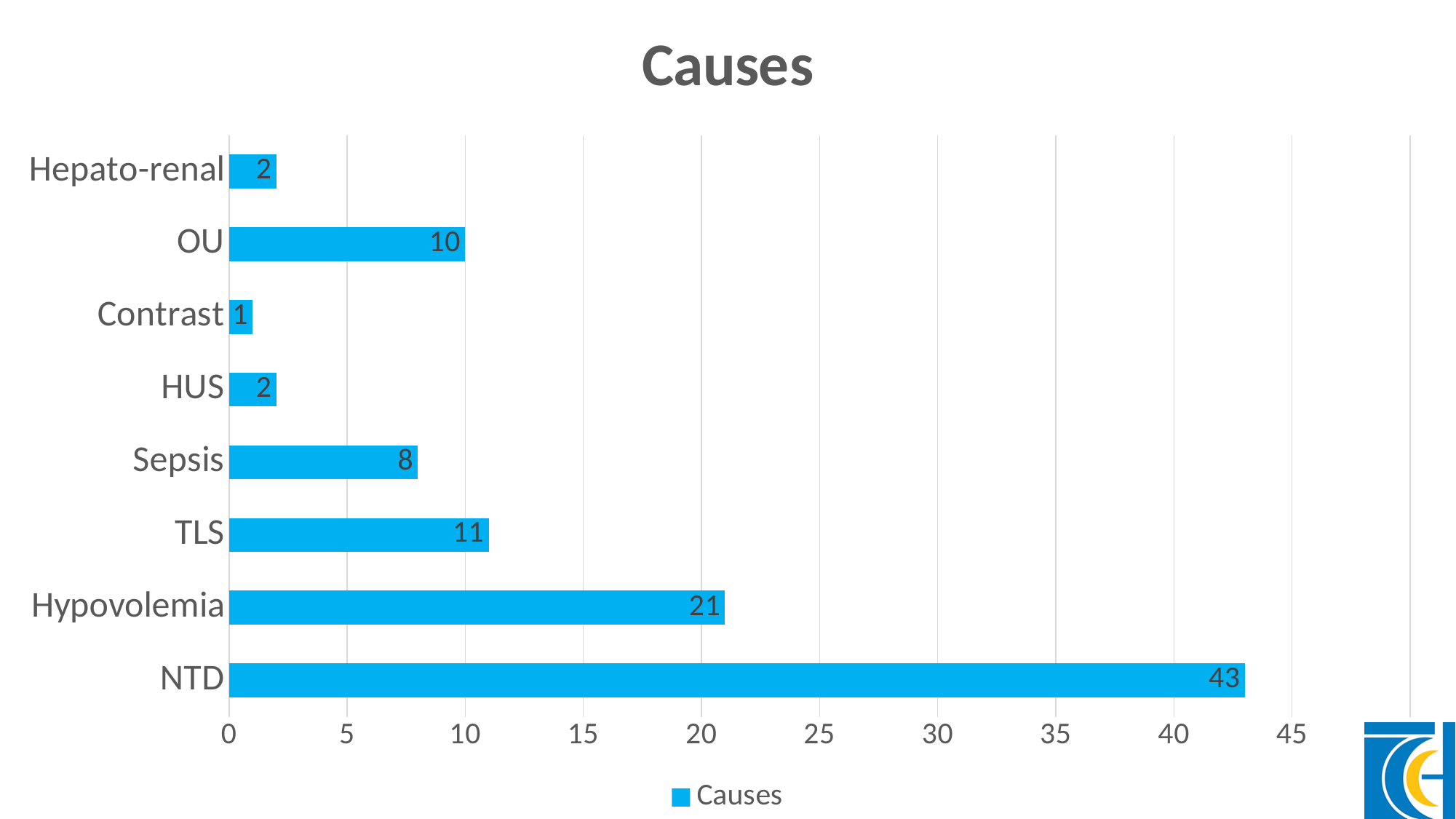
What is the difference between the values for TLS and OU? 1 Which is larger, the value for TLS or the value for Sepsis? TLS What is the title of the chart? Causes Is the value for Hypovolemia greater or less than 20? greater What is the difference between the values for NTD and Hypovolemia? 22 What is the value for Hypovolemia? 21 Which cause has the highest value? NTD What is the value for Sepsis? 8 What is the value for NTD? 43 How many causes are shown on the chart? 8 What kind of chart is shown on the slide? bar chart Which cause has the lowest value? Contrast